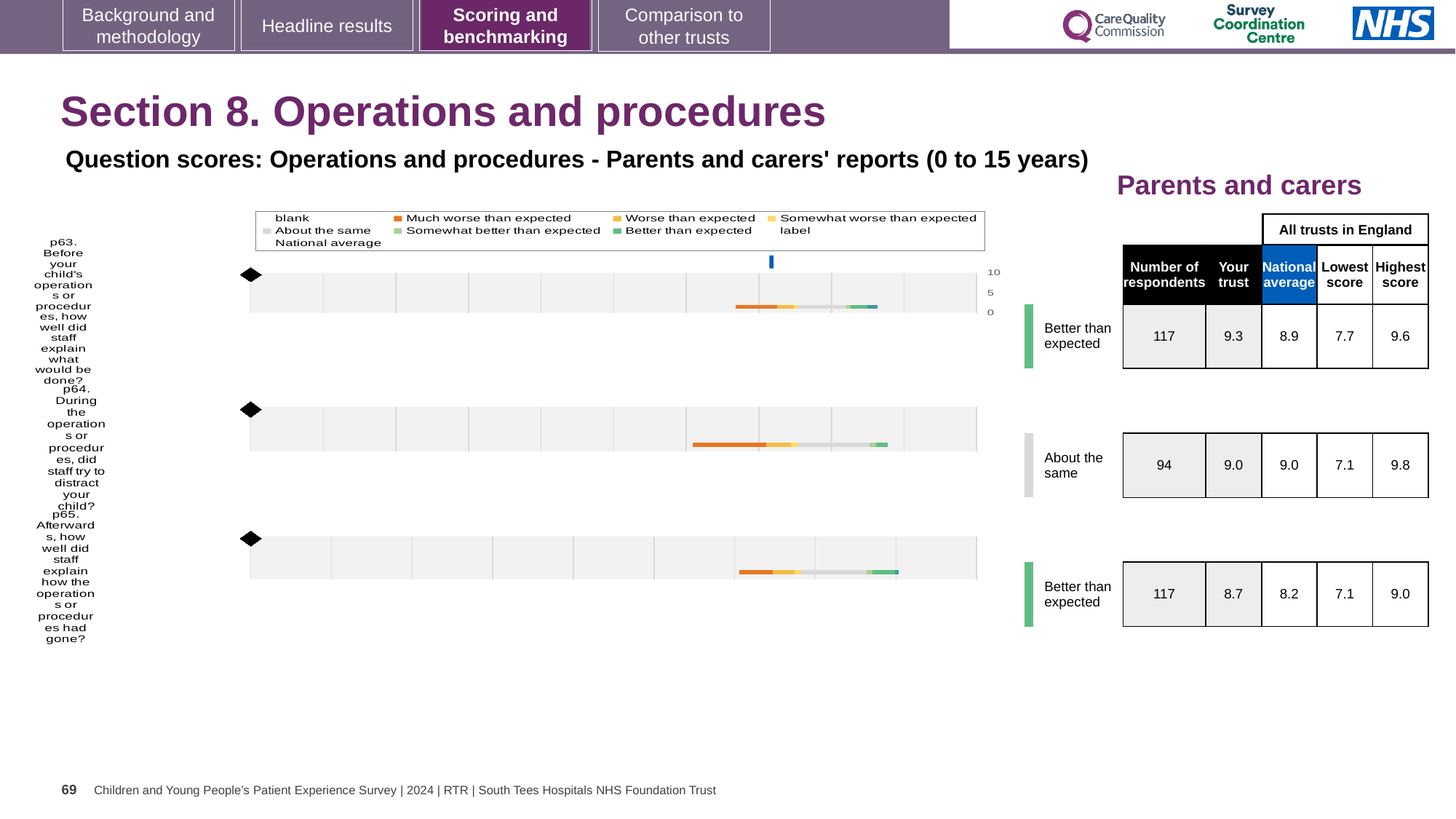
Which question has the highest 'Your trust' score? p63 What is the 'Your trust' score for p63 (how well staff explained what would be done before the operation)? 9.3 What is the lowest score across all trusts in England for p63? 7.7 How many questions (categories) are plotted in the chart? 3 Which has the higher 'Highest score' across all trusts in England: p63 or p65? p63 What kind of chart is used to show the question scores for Operations and procedures? Bar chart By how much does the trust's score for p63 exceed the national average for p63? 0.4 What is the national average score for p65 (how well staff explained how the operation had gone)? 8.2 Which question has the lowest 'Your trust' score? p65 How many entries does the chart legend list? 9 How many respondents answered p64 (did staff try to distract your child during the operation)? 94 What benchmark category is shown for p64? About the same